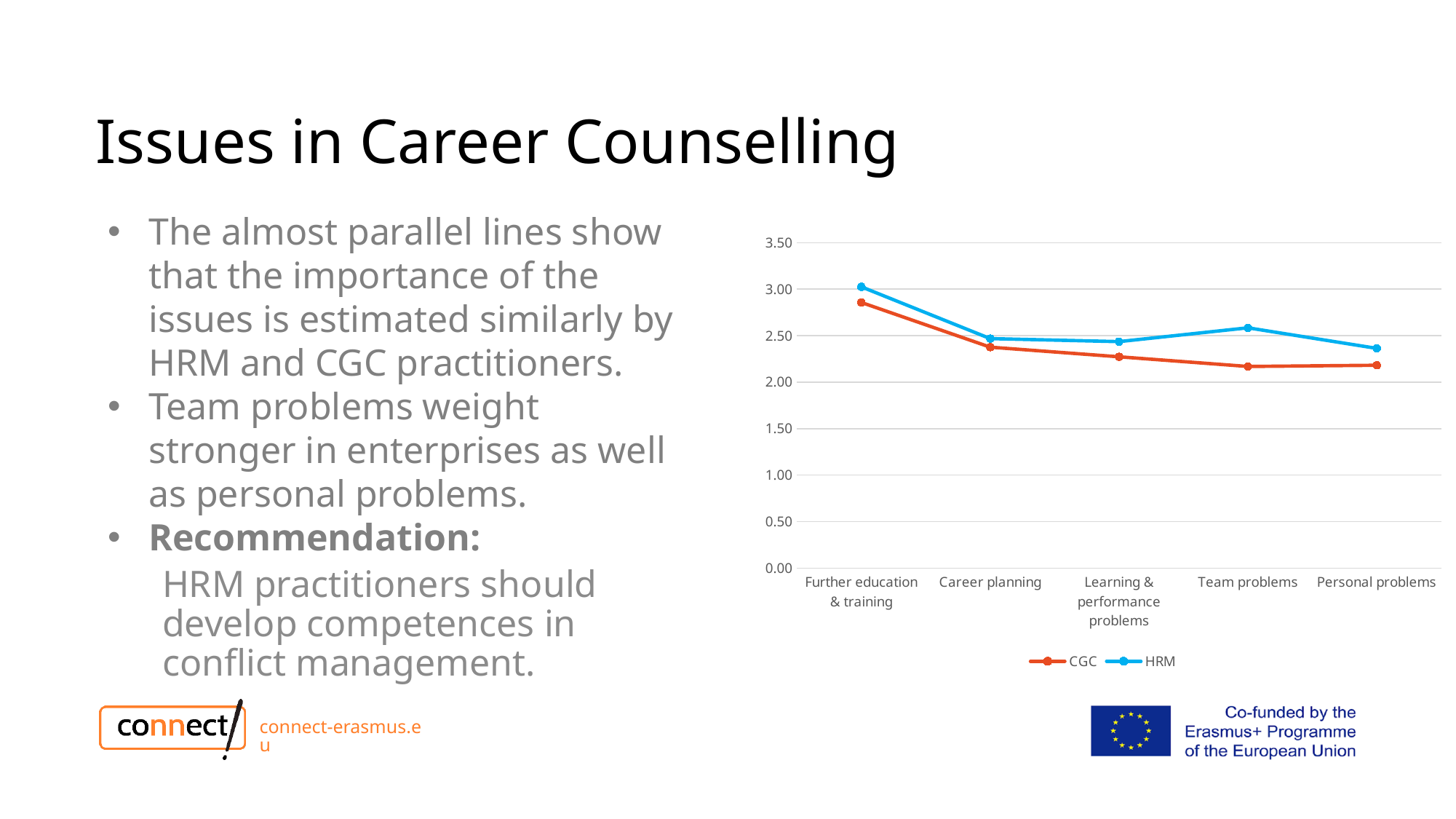
How many series does the chart legend list? 2 What kind of chart is shown on the slide? line chart Does the CGC line generally rise or fall from Further education & training to Personal problems? fall Which category has the highest value for the HRM series? Further education & training Is the HRM value for Team problems greater or less than 2.50? greater For Further education & training, which series has the larger value, CGC or HRM? HRM Which colour is used for the HRM series in the chart? blue Is the CGC value for Team problems greater or less than 2.00? greater For Team problems, which series has the larger value, CGC or HRM? HRM Which category has the highest value for the CGC series? Further education & training Is the CGC value for Further education & training greater or less than 3.00? less How many categories are shown on the x axis of the chart? 5